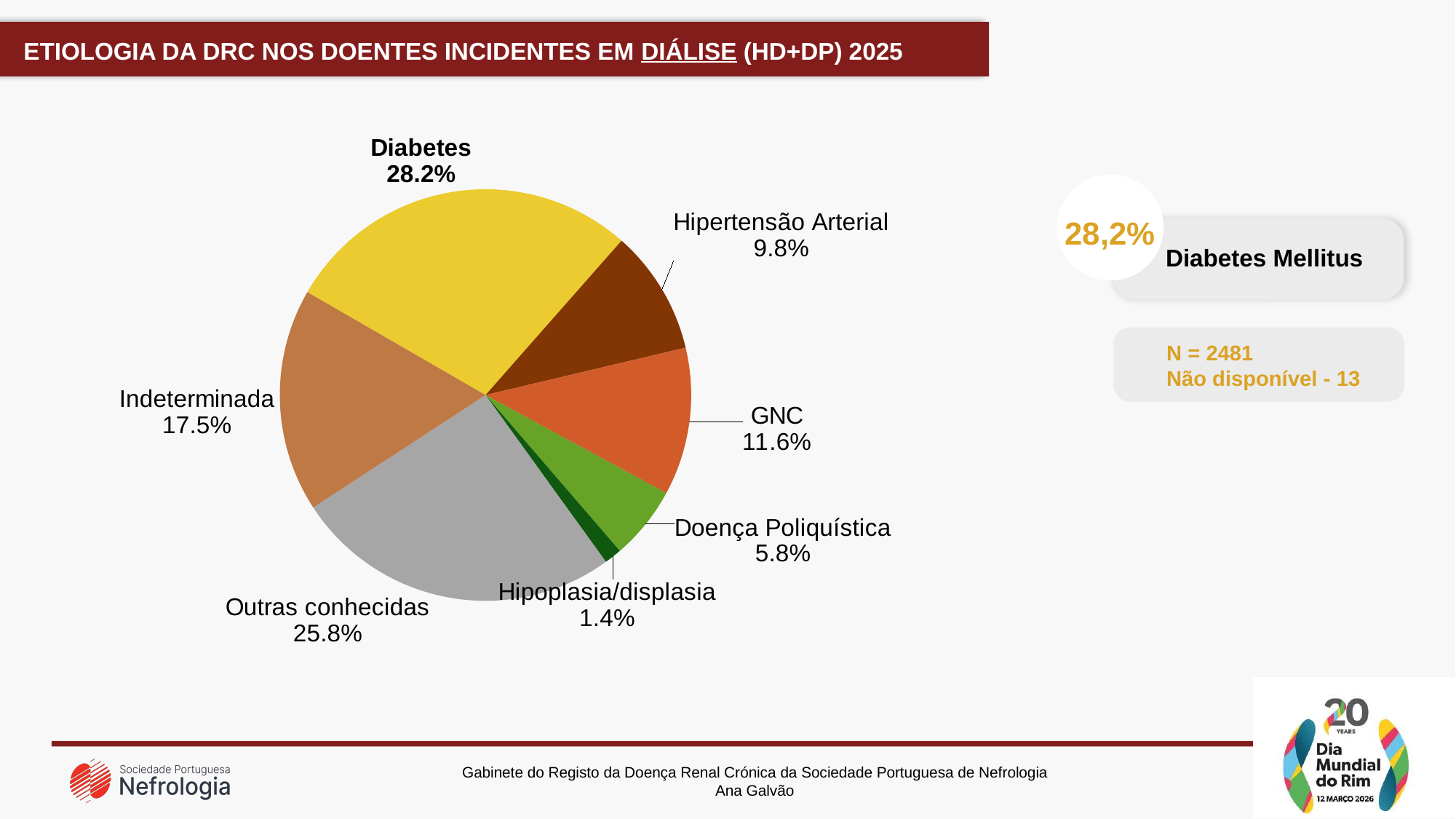
What is the value shown for GNC? 11.6% What colour is the Diabetes slice of the pie? yellow Which category has the largest slice of the pie? Diabetes What share of the pie does Diabetes represent? 28.2% Which category has the smallest slice of the pie? Hipoplasia/displasia What kind of chart is shown on the slide? pie chart What is the difference between the Diabetes share and the Indeterminada share? 10.7% Which is larger, the share for GNC or the share for Doença Poliquística? GNC What is the difference between the Outras conhecidas share and the Hipertensão Arterial share? 16.0% How many categories are shown in the pie chart? 7 What is the value shown for Outras conhecidas? 25.8% What is the value shown for Hipertensão Arterial? 9.8%